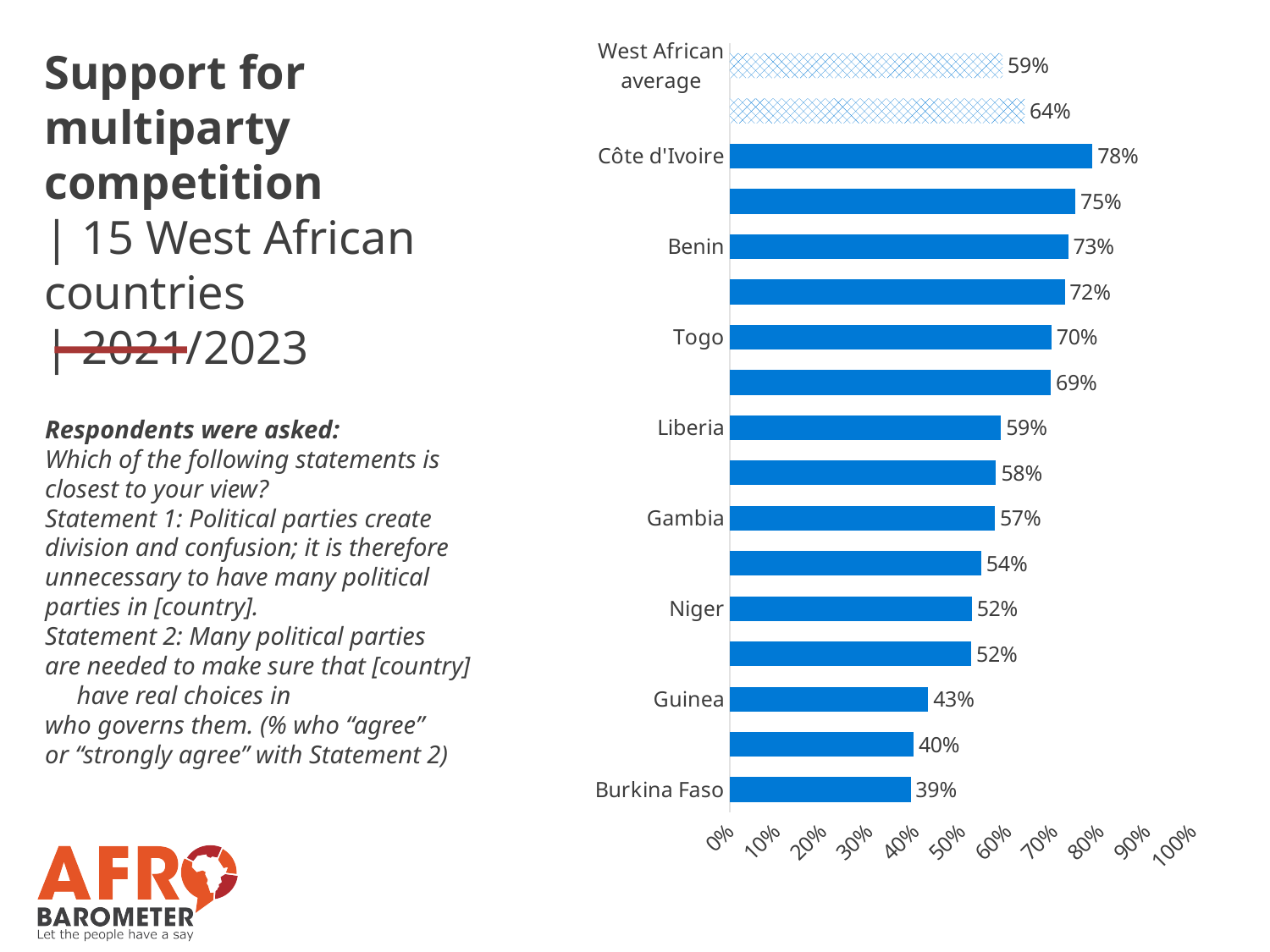
What is the value for Côte d'Ivoire? 78% What is the value for Burkina Faso? 39% Which has a larger value, Benin or Togo? Benin What is the value for Liberia? 59% What is the value for Benin? 73% Which country has the highest value on the chart? Côte d'Ivoire Is the value for Guinea greater or less than 50%? less What is the difference between the values for Côte d'Ivoire and Burkina Faso? 39 percentage points What is the value for Gambia? 57% Which country has the lowest value on the chart? Burkina Faso What kind of chart is shown on the slide? Bar chart What is the value for Togo? 70%